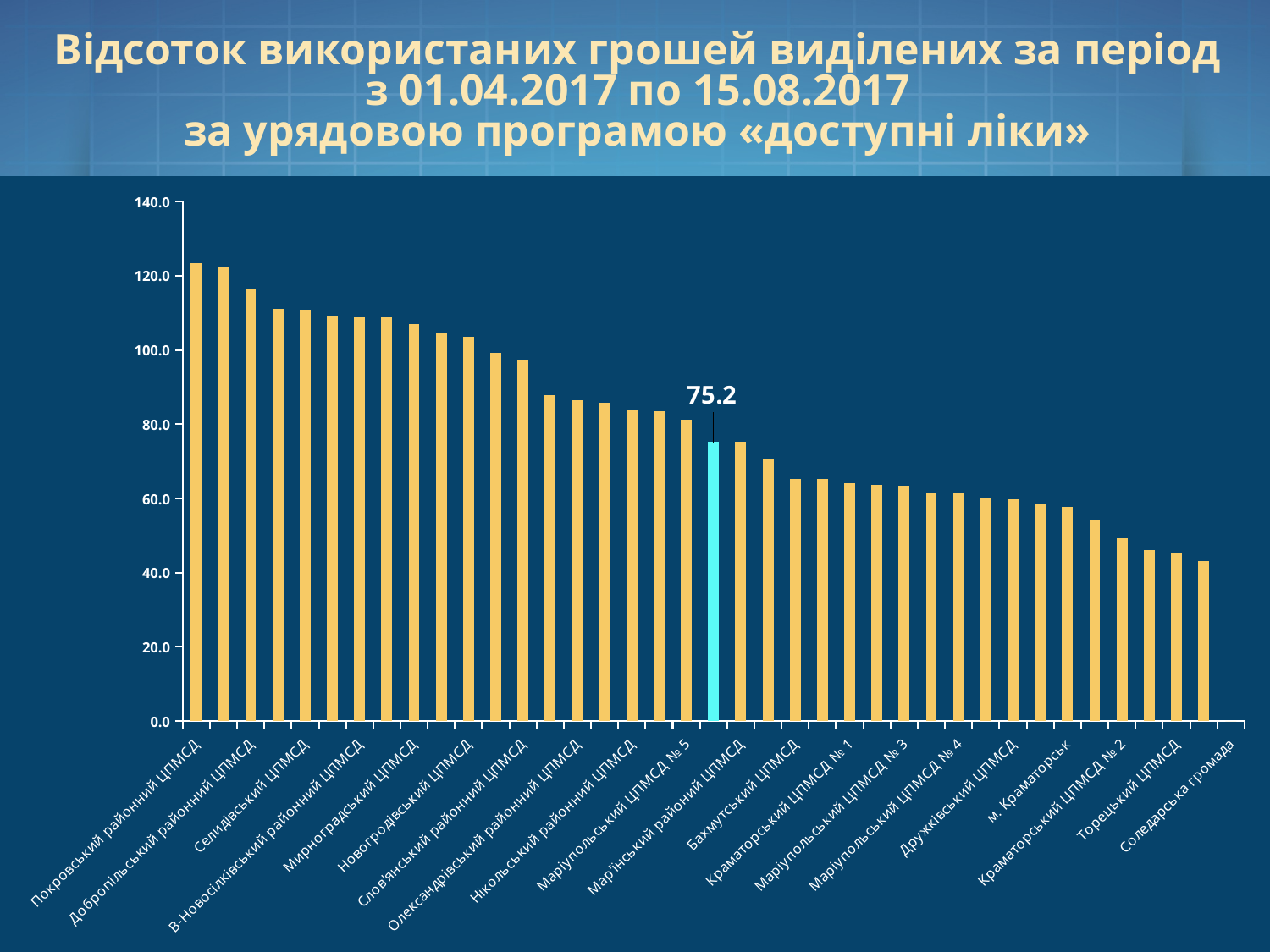
Is the value of the highlighted bar (75.2) greater or less than 80? less Is the value for Покровський районний ЦПМСД greater or less than 100? greater Which category has the highest value? Покровський районний ЦПМСД Is the value for Соледарська громада greater or less than 60? less What value is printed above the highlighted light-blue bar? 75.2 What colour is the single highlighted bar that differs from the others? light blue (cyan) Do the values rise or fall from left to right along the x axis? fall Which category has the lowest value? Соледарська громада What is the highest tick value shown on the y axis? 140.0 Which is larger, the value for Покровський районний ЦПМСД or the value for Соледарська громада? Покровський районний ЦПМСД What kind of chart is shown on the slide? bar chart